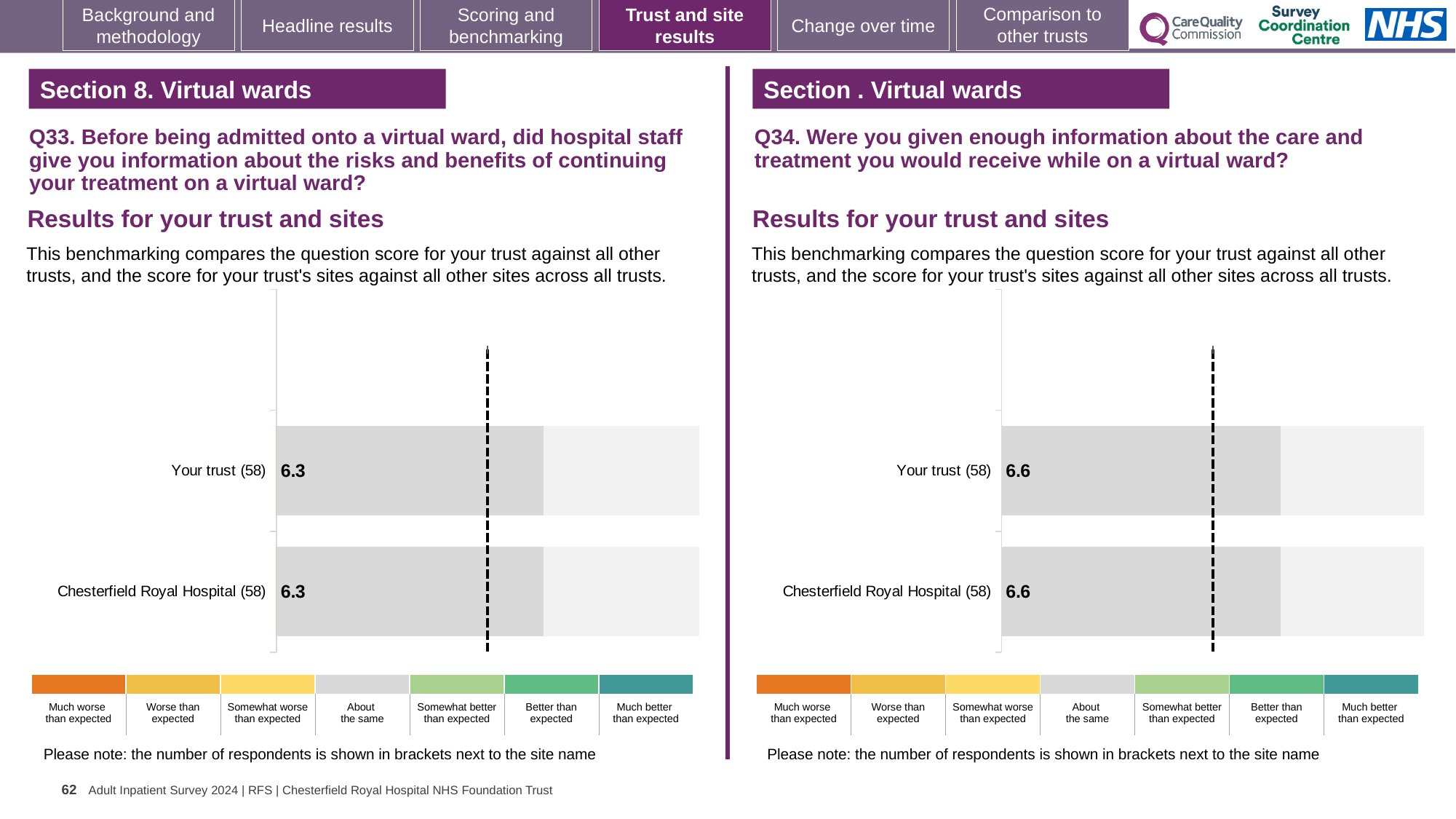
In the Q34 chart on the right, what is the score for Your trust (58)? 6.6 In the Q34 chart on the right, what is the difference between the score for Your trust and the score for Chesterfield Royal Hospital? 0 How many bars are plotted in the Q34 chart on the right? 2 How many bars are plotted in the Q33 chart on the left? 2 What kind of chart is used for the Q33 results on the left? bar chart In the Q33 chart on the left, what is the score for Your trust (58)? 6.3 In the Q33 chart on the left, what is the score for Chesterfield Royal Hospital (58)? 6.3 In the Q34 chart on the right, what is the score for Chesterfield Royal Hospital (58)? 6.6 In the Q34 chart on the right, how many respondents are shown in brackets next to Chesterfield Royal Hospital? 58 In the Q33 chart on the left, what is the difference between the score for Your trust and the score for Chesterfield Royal Hospital? 0 How many rating bands are shown in the colour key below the Q33 chart on the left? 7 In the Q33 chart on the left, is the score for Your trust larger than, smaller than, or the same as the score for Chesterfield Royal Hospital? the same